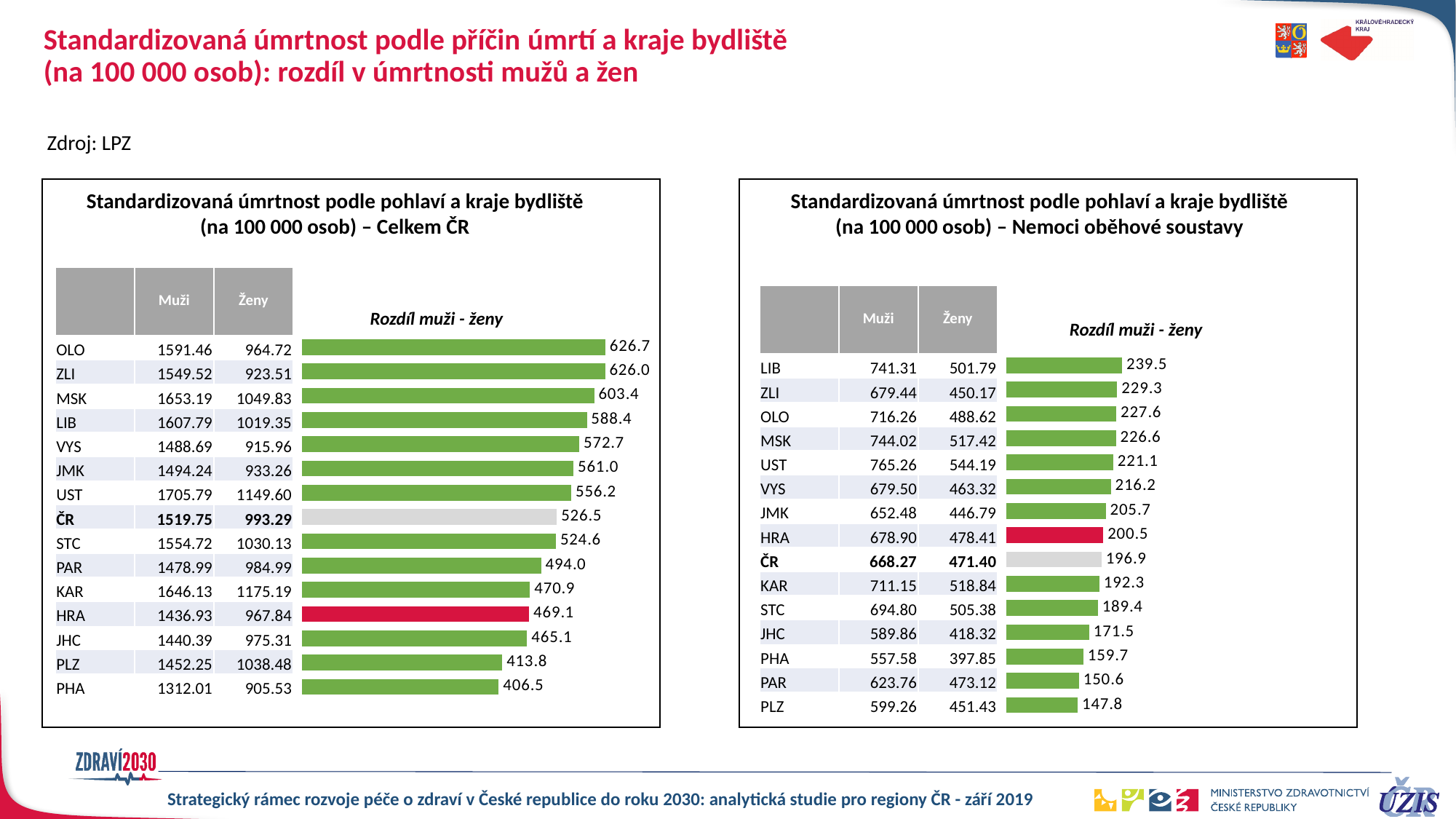
In the right chart (Nemoci oběhové soustavy), what is the Ženy value for PLZ? 451.43 In the left chart (Celkem ČR), what is the difference between the Rozdíl muži - ženy values for OLO and PHA? 220.2 In the right chart (Nemoci oběhové soustavy), which region has the highest Rozdíl muži - ženy value? LIB In the left chart (Celkem ČR), which region has the lowest Rozdíl muži - ženy value? PHA In the left chart (Celkem ČR), which region's bar is coloured red? HRA In the left chart (Celkem ČR), what is the Ženy value for UST? 1149.60 In the left chart (Celkem ČR), what is the Muži value for ČR? 1519.75 In the right chart (Nemoci oběhové soustavy), which has the larger Rozdíl muži - ženy value, HRA or ČR? HRA In the right chart (Nemoci oběhové soustavy), what is the Muži value for HRA? 678.90 In the left chart (Celkem ČR), what is the Rozdíl muži - ženy value for OLO? 626.7 How many regions (rows) are shown in the left chart (Celkem ČR)? 15 What kind of chart is used to show Rozdíl muži - ženy in the right chart? bar chart